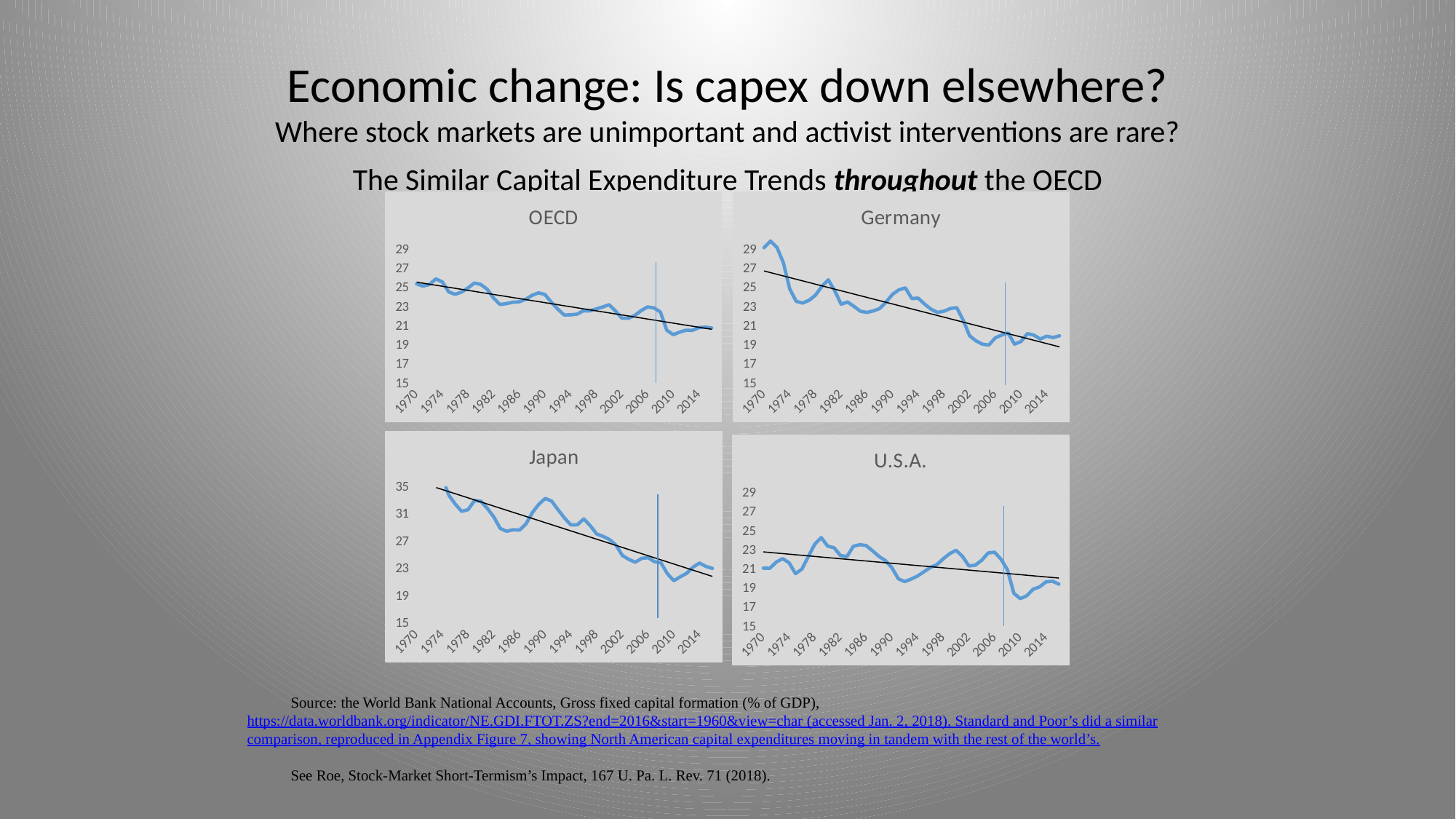
In the Japan chart, is the value for 2010 greater or less than 23? less In the Japan chart, is the value for 1974 greater or less than 31? greater How many charts are shown on the slide? 4 In the U.S.A. chart, is the overall trend of the line rising or falling? falling In the Germany chart, is the value for 2010 greater or less than 21? less In the Germany chart, do the values generally rise or fall from 1970 to 2014? fall What kind of chart is the OECD chart? line chart What is the highest value shown on the y axis of the Japan chart? 35 In the Japan chart, do the values generally rise or fall along the x axis? fall